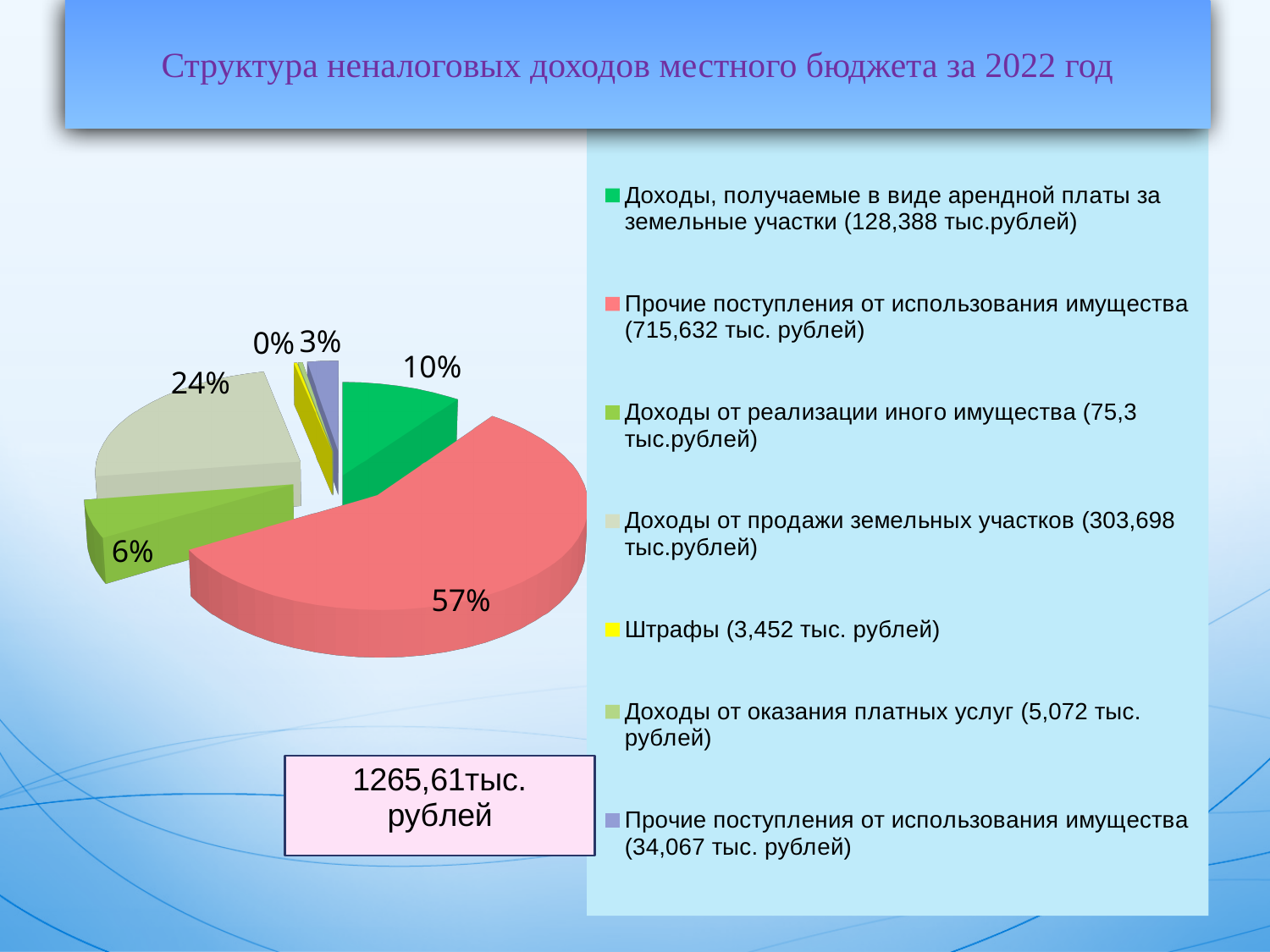
How many entries does the legend of the pie chart list? 7 What share of the pie is labelled for 'Доходы от реализации иного имущества'? 6% What is the difference in percentage points between the 57% slice and the 24% slice? 33 What kind of chart is shown on the slide? Pie chart What share of the pie is labelled for 'Доходы, получаемые в виде арендной платы за земельные участки'? 10% Which category has the largest slice of the pie? Прочие поступления от использования имущества (715,632 тыс. рублей) What share of the pie does the largest slice have? 57% Which slice is larger: 'Доходы от продажи земельных участков' or 'Доходы, получаемые в виде арендной платы за земельные участки'? Доходы от продажи земельных участков What is the title of the slide containing the pie chart? Структура неналоговых доходов местного бюджета за 2022 год What total amount is shown in the box below the pie chart? 1265,61 тыс. рублей According to the legend, what amount is given for 'Штрафы'? 3,452 тыс. рублей